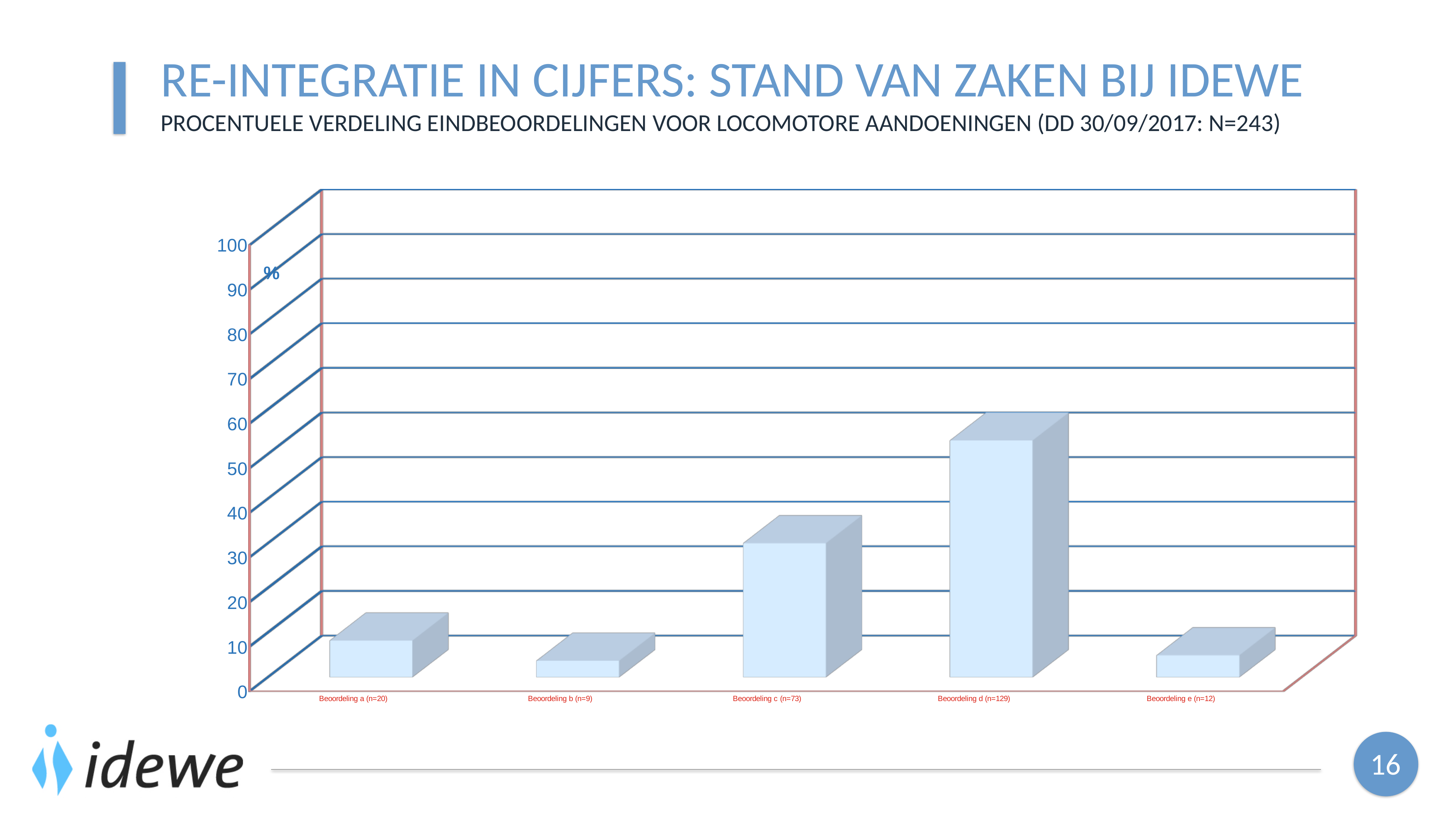
Which category has the highest percentage? Beoordeling d (n=129) What kind of chart is shown on the slide? bar chart Is the value for Beoordeling d (n=129) greater or less than 50? greater What unit is shown on the vertical axis of the chart? % Which is larger, the value for Beoordeling c (n=73) or Beoordeling a (n=20)? Beoordeling c (n=73) Is the value for Beoordeling a (n=20) greater or less than 20? less Is the value for Beoordeling d (n=129) greater or less than 60? less Which is larger, the value for Beoordeling d (n=129) or Beoordeling c (n=73)? Beoordeling d (n=129) How many categories (Beoordeling bars) are shown in the chart? 5